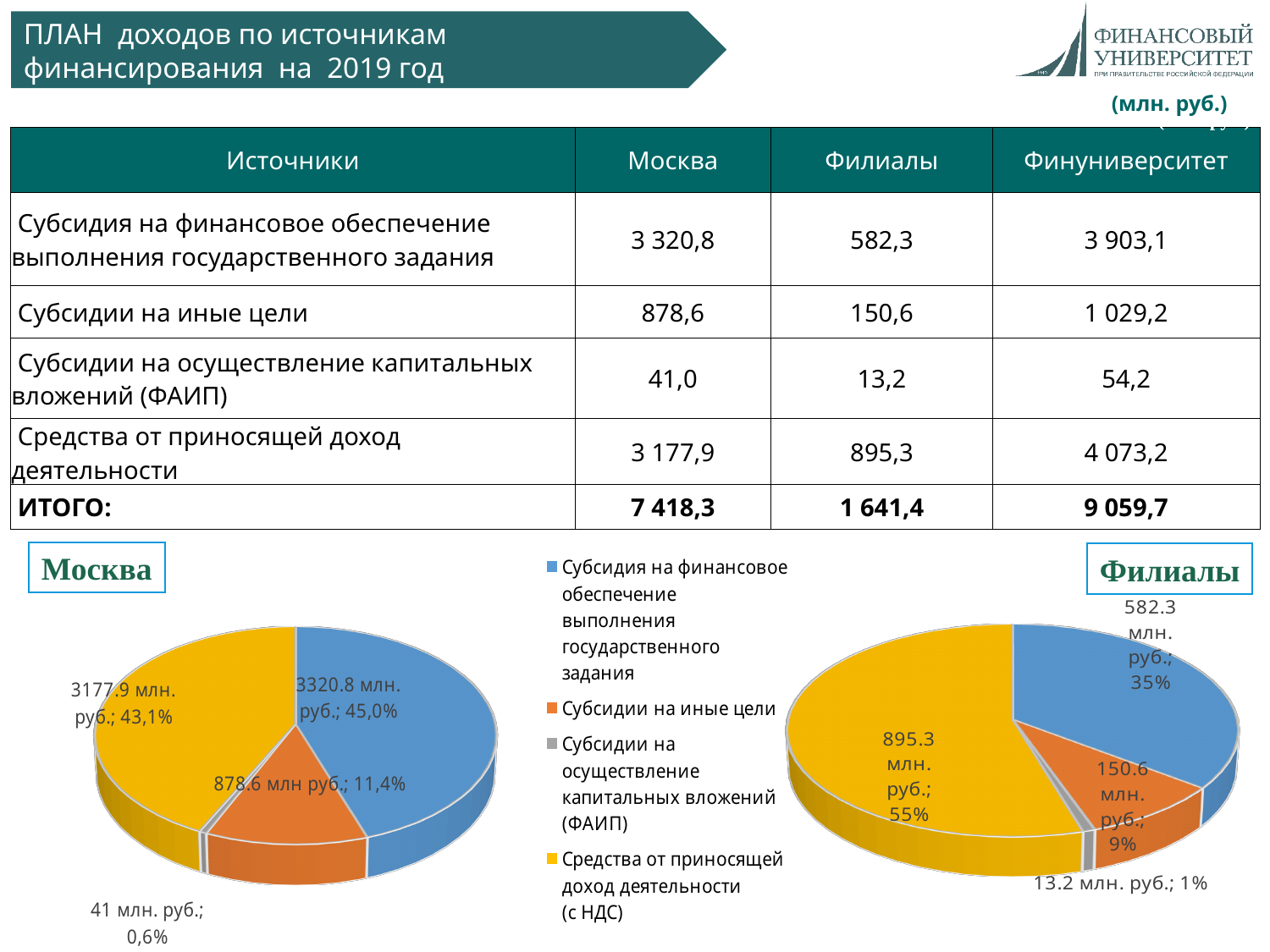
How many entries does the shared legend between the two pie charts list? 4 How many slices does the "Москва" chart have? 4 In the "Филиалы" chart, what value is shown for "Субсидия на финансовое обеспечение выполнения государственного задания"? 582.3 млн. руб. In the "Москва" chart, which category has the smallest slice? Субсидии на осуществление капитальных вложений (ФАИП) In the "Филиалы" chart, what share does "Субсидии на иные цели" have? 9% In the "Филиалы" chart, which category has the largest slice? Средства от приносящей доход деятельности (с НДС) In the "Филиалы" chart, which is larger: "Средства от приносящей доход деятельности (с НДС)" or "Субсидия на финансовое обеспечение выполнения государственного задания"? Средства от приносящей доход деятельности (с НДС) In the "Москва" chart, what share does "Средства от приносящей доход деятельности (с НДС)" have? 43,1% In the "Москва" chart, what value is shown for "Субсидии на иные цели"? 878.6 млн руб. In the "Москва" chart, what share does "Субсидия на финансовое обеспечение выполнения государственного задания" have? 45,0% What type of chart is used for the "Москва" chart? pie chart In the "Филиалы" chart, what value is shown for "Субсидии на осуществление капитальных вложений (ФАИП)"? 13.2 млн. руб.